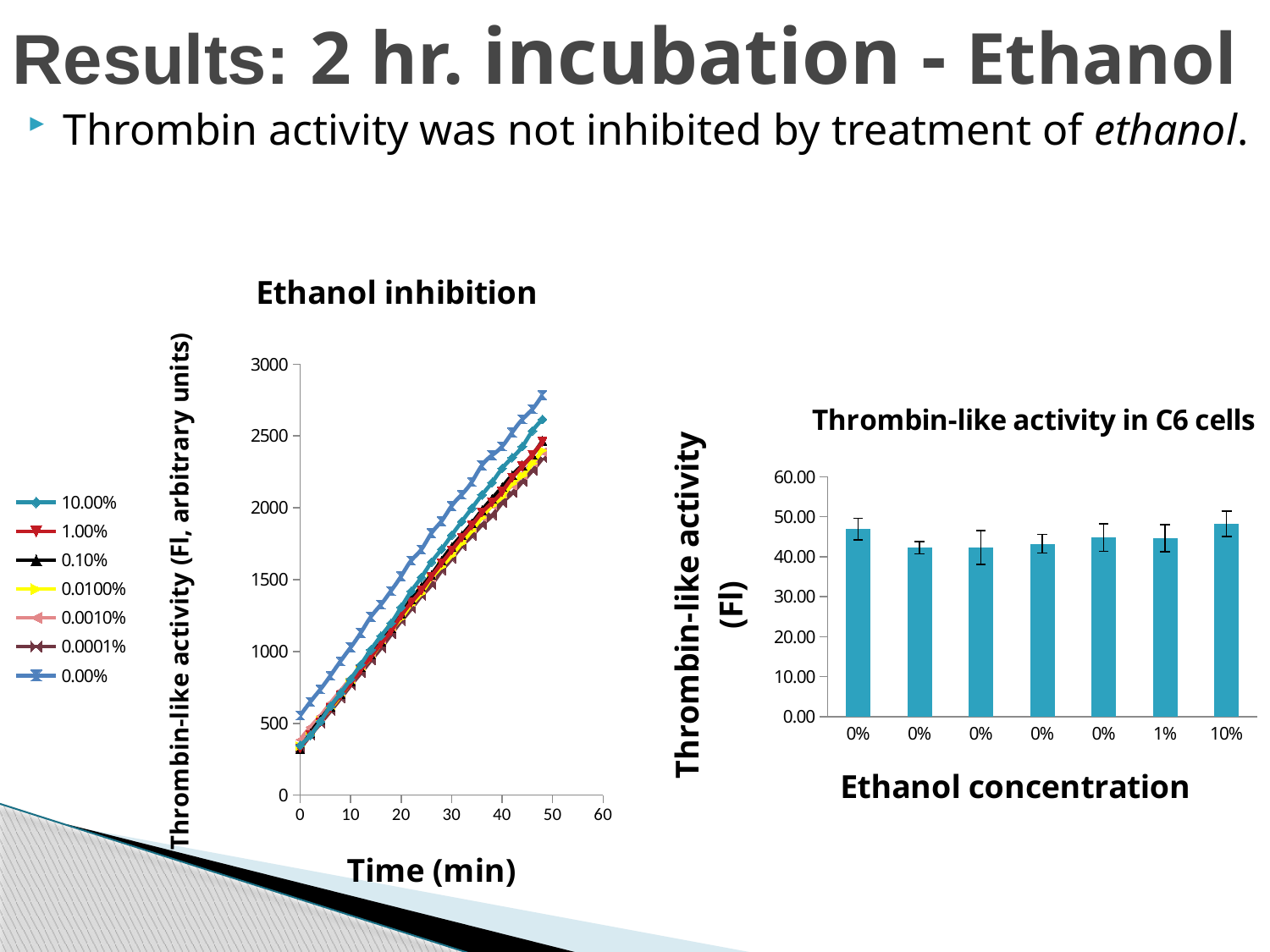
How many series does the legend of the "Ethanol inhibition" chart list? 7 What kind of chart is the "Ethanol inhibition" chart on the left? line chart In the "Ethanol inhibition" chart, do the values rise or fall as time increases? rise What is the x-axis title of the "Thrombin-like activity in C6 cells" chart? Ethanol concentration What kind of chart is the "Thrombin-like activity in C6 cells" chart on the right? bar chart In the "Thrombin-like activity in C6 cells" chart, is the value for 1% greater or less than 50.00? less How many bars are plotted in the "Thrombin-like activity in C6 cells" chart? 7 In the "Ethanol inhibition" chart, is the value of the 0.00% series at 48 min greater or less than 2500? greater In the "Ethanol inhibition" chart, is the value of the 0.0001% series at 48 min greater or less than 2500? less In the "Ethanol inhibition" chart, which series has the highest value at 48 min? 0.00%